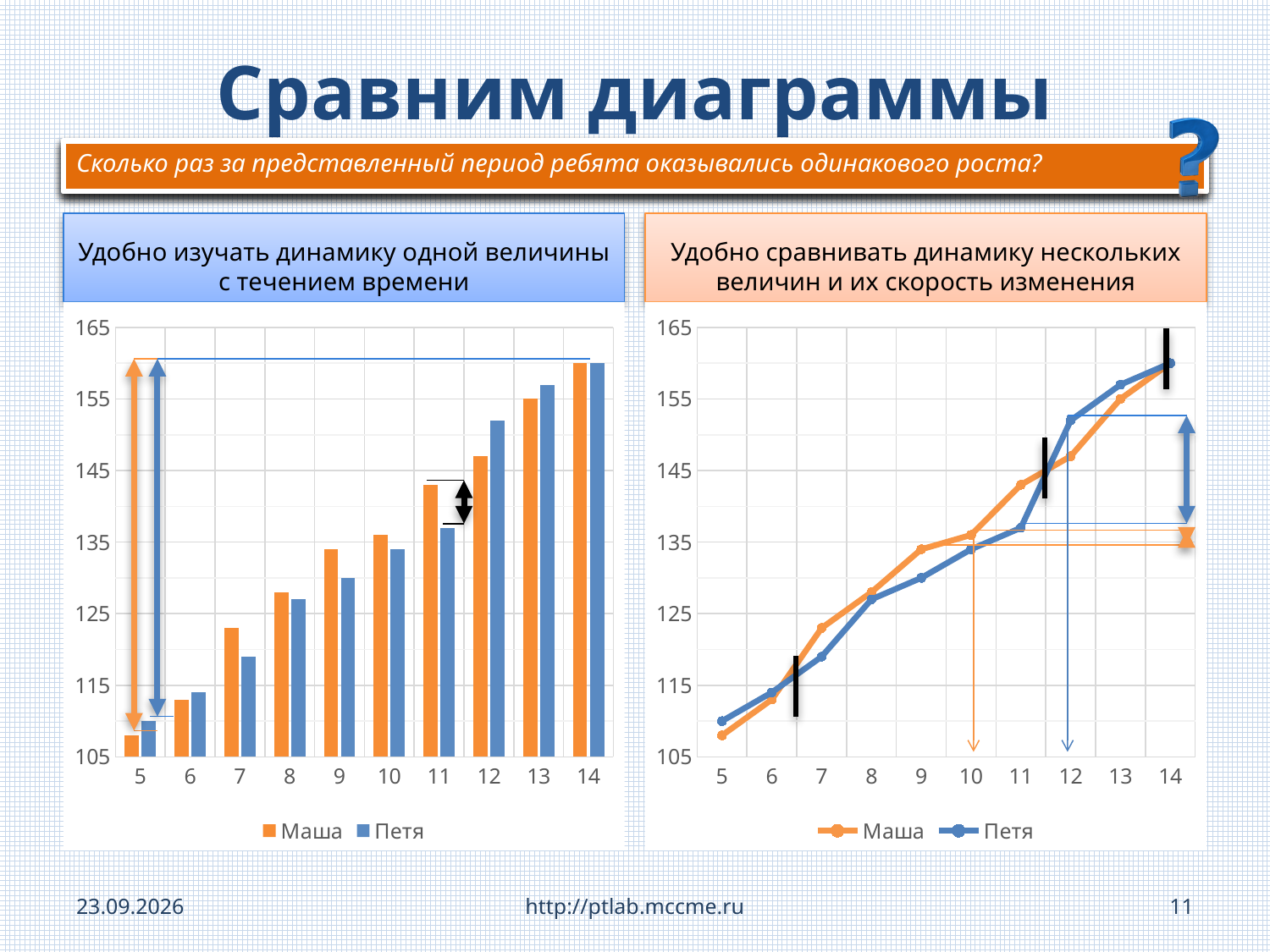
In the left bar chart, is the value for Петя at 11 greater or less than 145? less What kind of chart is the left chart on the slide? bar chart In the left bar chart, at which x-axis value is the bar for Маша lowest? 5 In the left bar chart, which series has the larger value at 12, Маша or Петя? Петя What kind of chart is the right chart on the slide? line chart In the left bar chart, how many series does the legend list? 2 In the left bar chart, is the value for Петя at 12 greater or less than 145? greater In the right line chart, do the values for Маша rise or fall along the x axis? rise In the left bar chart, how many categories are shown on the x axis? 10 In the left bar chart, which series has the larger value at 7, Маша or Петя? Маша In the right line chart, is the value for Петя at 5 greater or less than 115? less In the left bar chart, at which x-axis value is the bar for Маша highest? 14